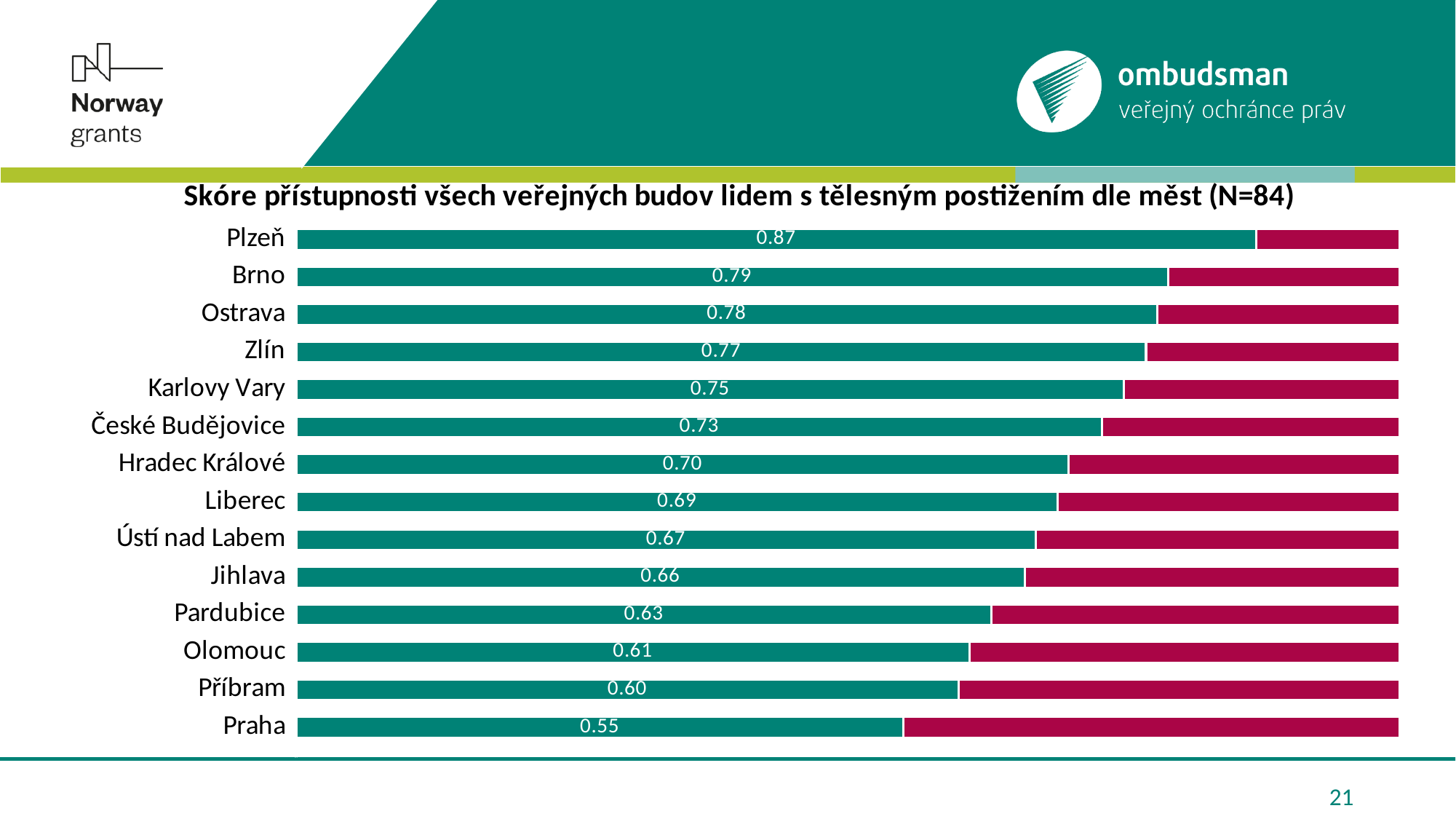
What is the accessibility score for Ústí nad Labem? 0.67 What is the difference between the scores of Brno and Olomouc? 0.18 What is the difference between the scores of Plzeň and Praha? 0.32 Which city has the lowest accessibility score? Praha Which city has the highest accessibility score? Plzeň What kind of chart is shown on the slide? Bar chart What is the accessibility score for Hradec Králové? 0.70 Which has a higher score, Karlovy Vary or Liberec? Karlovy Vary How many cities are shown in the chart? 14 What is the accessibility score for Praha? 0.55 What is the title of the chart? Skóre přístupnosti všech veřejných budov lidem s tělesným postižením dle měst (N=84) What is the accessibility score for Plzeň? 0.87